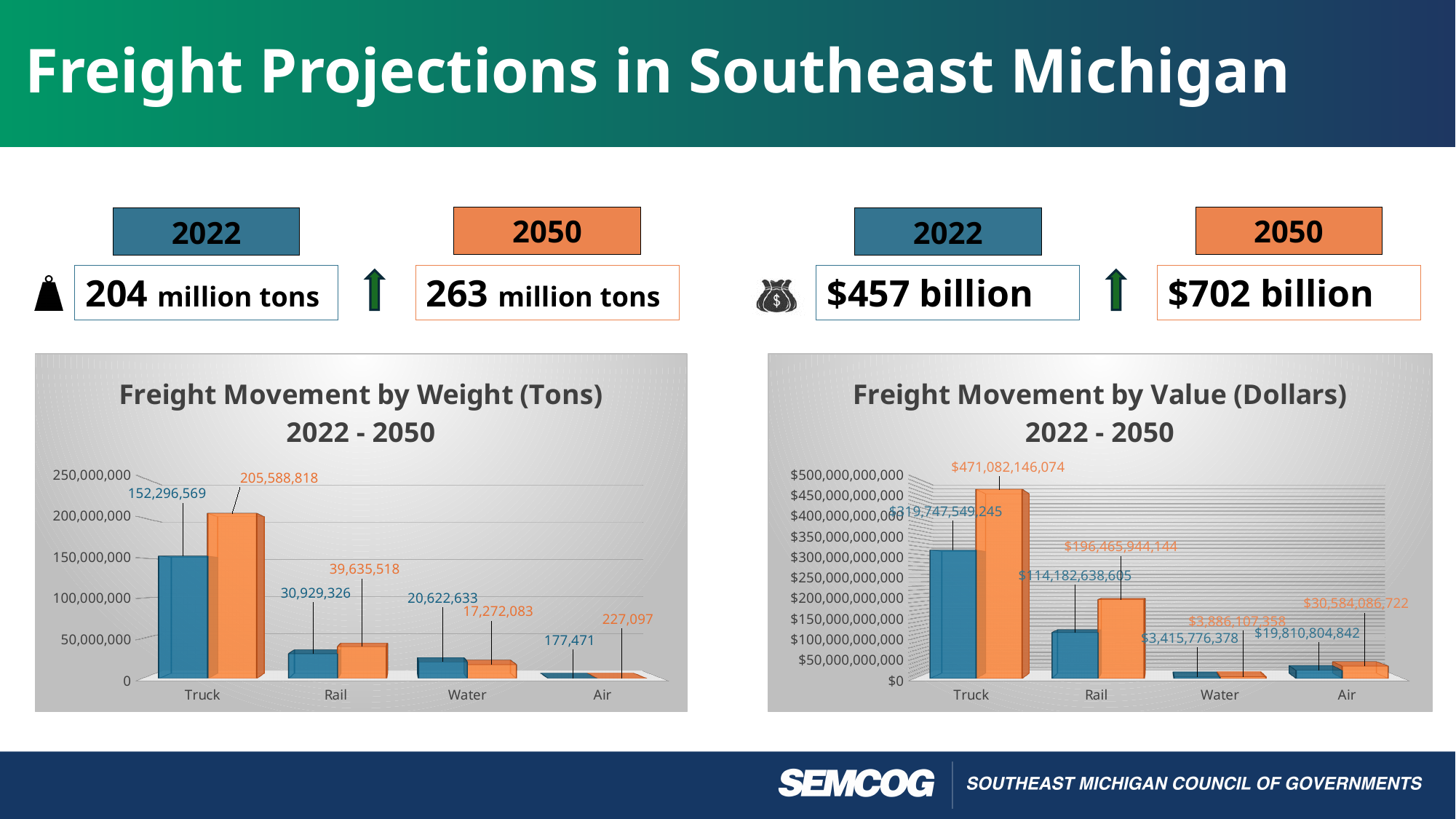
In the Freight Movement by Weight (Tons) chart, what is the 2050 value for Rail? 39,635,518 In the Freight Movement by Weight (Tons) chart, is the Water value larger in 2022 or in 2050? 2022 In the Freight Movement by Weight (Tons) chart, what is the difference between the 2050 and 2022 values for Truck? 53,292,249 How many freight modes are shown on the x axis of the Freight Movement by Weight (Tons) chart? 4 In the Freight Movement by Weight (Tons) chart, which mode has the lowest 2050 value? Air In the Freight Movement by Value (Dollars) chart, what is the 2022 value for Air? $19,810,804,842 In the Freight Movement by Value (Dollars) chart, which mode has the highest 2022 value? Truck In the Freight Movement by Value (Dollars) chart, what is the 2050 value for Truck? $471,082,146,074 In the Freight Movement by Value (Dollars) chart, what is the difference between the 2050 and 2022 values for Air? $10,773,281,880 What kind of chart is the Freight Movement by Value (Dollars) chart? bar chart In the Freight Movement by Weight (Tons) chart, what is the 2022 value for Truck? 152,296,569 In the Freight Movement by Value (Dollars) chart, is the 2050 value for Rail greater or less than $150,000,000,000? greater